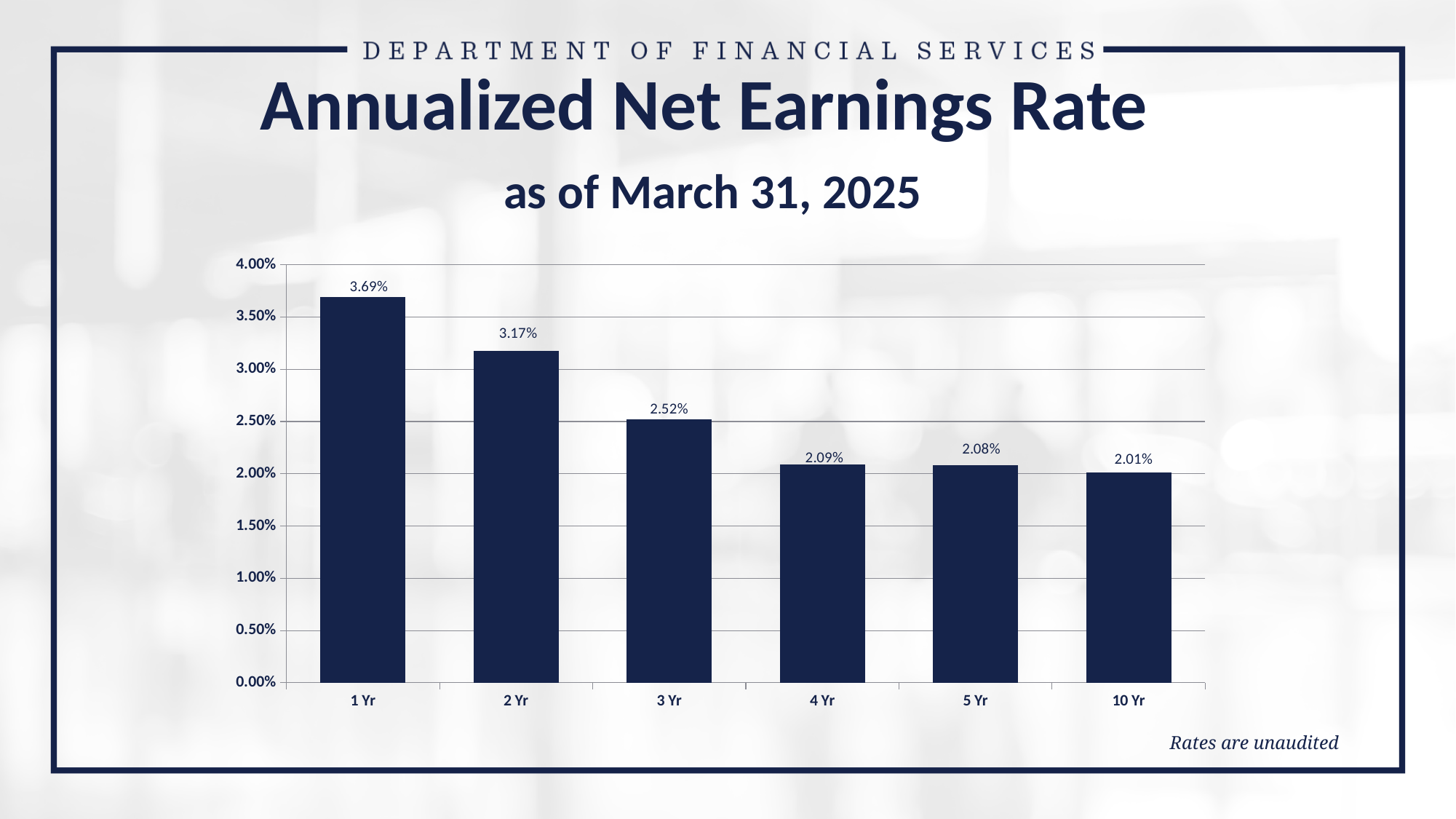
What kind of chart is shown on the slide? Bar chart What is the annualized net earnings rate for 3 Yr? 2.52% What is the difference between the 1 Yr and 2 Yr annualized net earnings rates? 0.52% What is the difference between the 3 Yr and 4 Yr annualized net earnings rates? 0.43% Do the annualized net earnings rates rise or fall from 1 Yr to 10 Yr? Fall Which period has the lowest annualized net earnings rate? 10 Yr Which is larger, the 2 Yr rate or the 3 Yr rate? 2 Yr Which period has the highest annualized net earnings rate? 1 Yr What is the annualized net earnings rate for 1 Yr? 3.69% Is the value for 2 Yr greater or less than 3.00%? greater What is the annualized net earnings rate for 10 Yr? 2.01% How many periods are shown on the x axis? 6